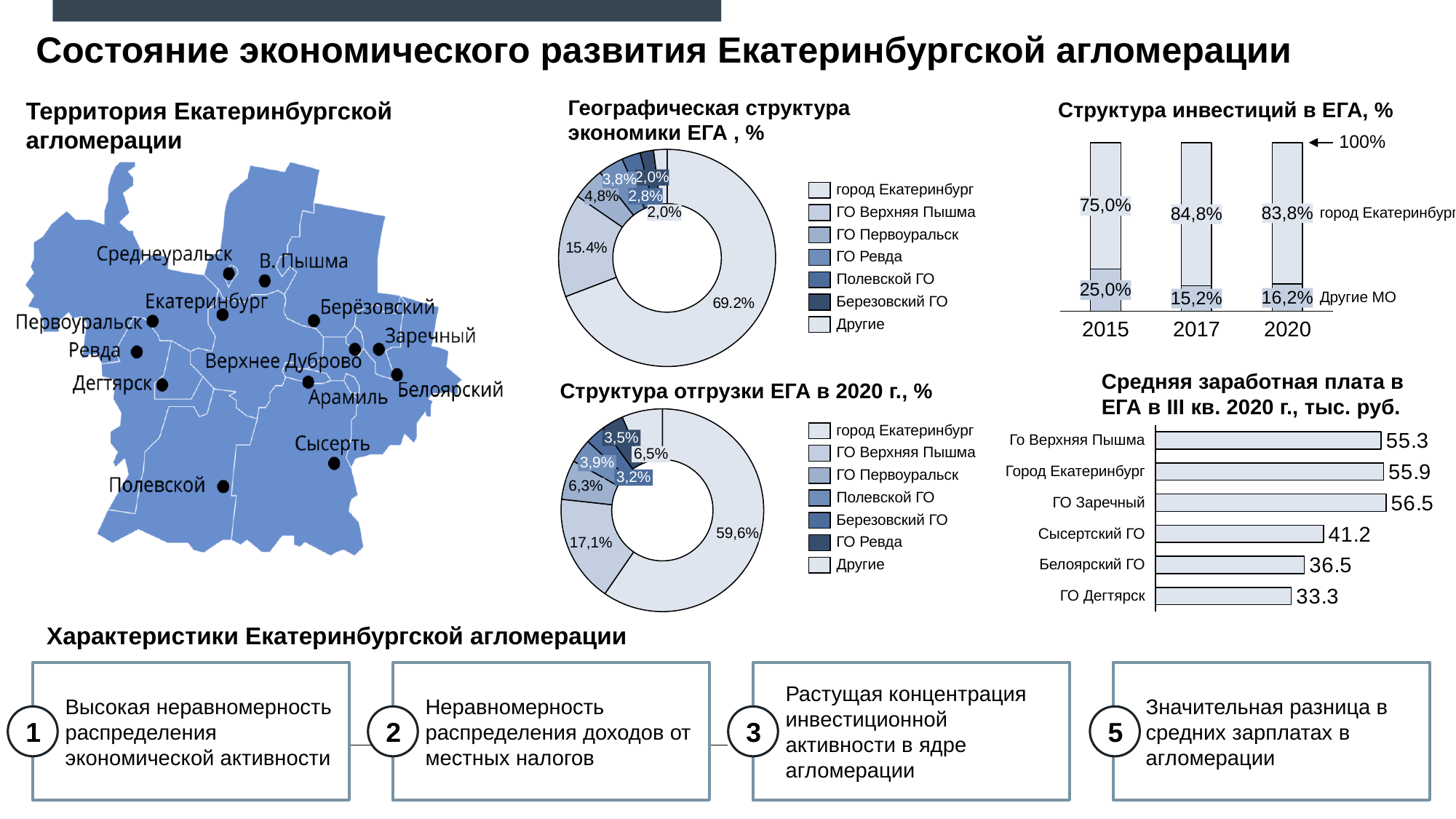
In the chart 'Структура отгрузки ЕГА в 2020 г., %', what is the share of ГО Верхняя Пышма? 17,1% What kind of chart is 'Средняя заработная плата в ЕГА в III кв. 2020 г., тыс. руб.'? bar chart How many entries does the legend of the chart 'Структура отгрузки ЕГА в 2020 г., %' list? 7 In the chart 'Средняя заработная плата в ЕГА в III кв. 2020 г., тыс. руб.', how many categories are shown? 6 In the chart 'Географическая структура экономики ЕГА, %', what is the share of город Екатеринбург? 69.2% In the chart 'Средняя заработная плата в ЕГА в III кв. 2020 г., тыс. руб.', what is the value for Сысертский ГО? 41.2 In the chart 'Структура инвестиций в ЕГА, %', what is the share of Другие МО in 2015? 25,0% In the chart 'Средняя заработная плата в ЕГА в III кв. 2020 г., тыс. руб.', which category has the highest value? ГО Заречный In the chart 'Структура инвестиций в ЕГА, %', is the share of город Екатеринбург larger in 2017 or in 2020? 2017 In the chart 'Средняя заработная плата в ЕГА в III кв. 2020 г., тыс. руб.', what is the difference between Город Екатеринбург and Белоярский ГО? 19.4 In the chart 'Средняя заработная плата в ЕГА в III кв. 2020 г., тыс. руб.', which category has the lowest value? ГО Дегтярск In the chart 'Структура инвестиций в ЕГА, %', what is the share of город Екатеринбург in 2017? 84,8%